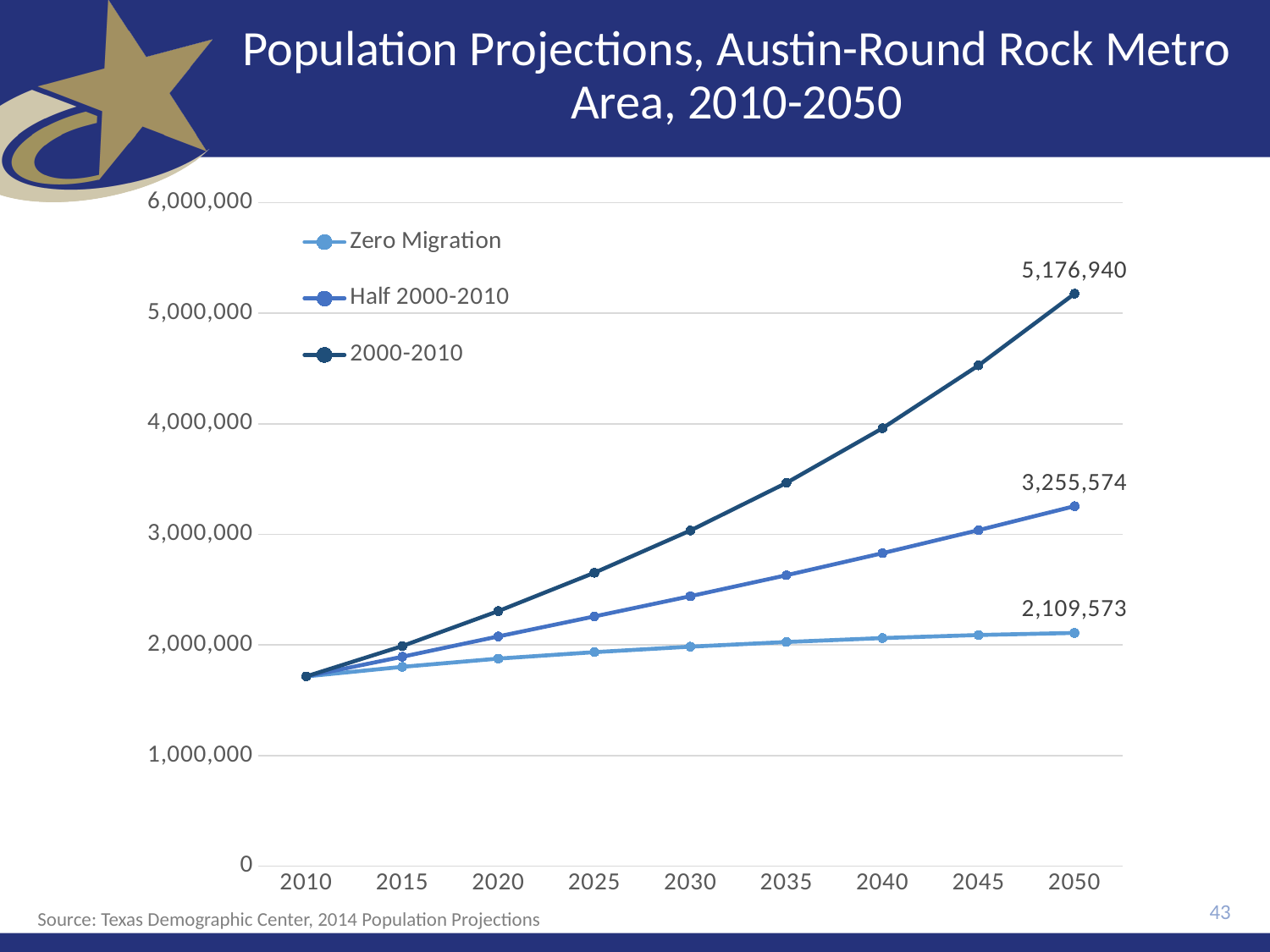
Is the 2030 value for the 2000-2010 scenario greater or less than 4,000,000? less How many years are shown on the x axis? 9 What is the projected 2050 population under the Zero Migration scenario? 2,109,573 Which scenario has the highest projected population in 2050? 2000-2010 What is the projected 2050 population under the Half 2000-2010 scenario? 3,255,574 How many series does the legend list? 3 Is the 2050 value for the Half 2000-2010 scenario greater or less than 3,000,000? greater What is the difference between the 2050 projections for the 2000-2010 and Zero Migration scenarios? 3,067,367 What is the projected 2050 population under the 2000-2010 scenario? 5,176,940 What kind of chart is shown on the slide? Line chart Which scenario has the lowest projected population in 2050? Zero Migration What is the difference between the 2050 projections for the 2000-2010 and Half 2000-2010 scenarios? 1,921,366